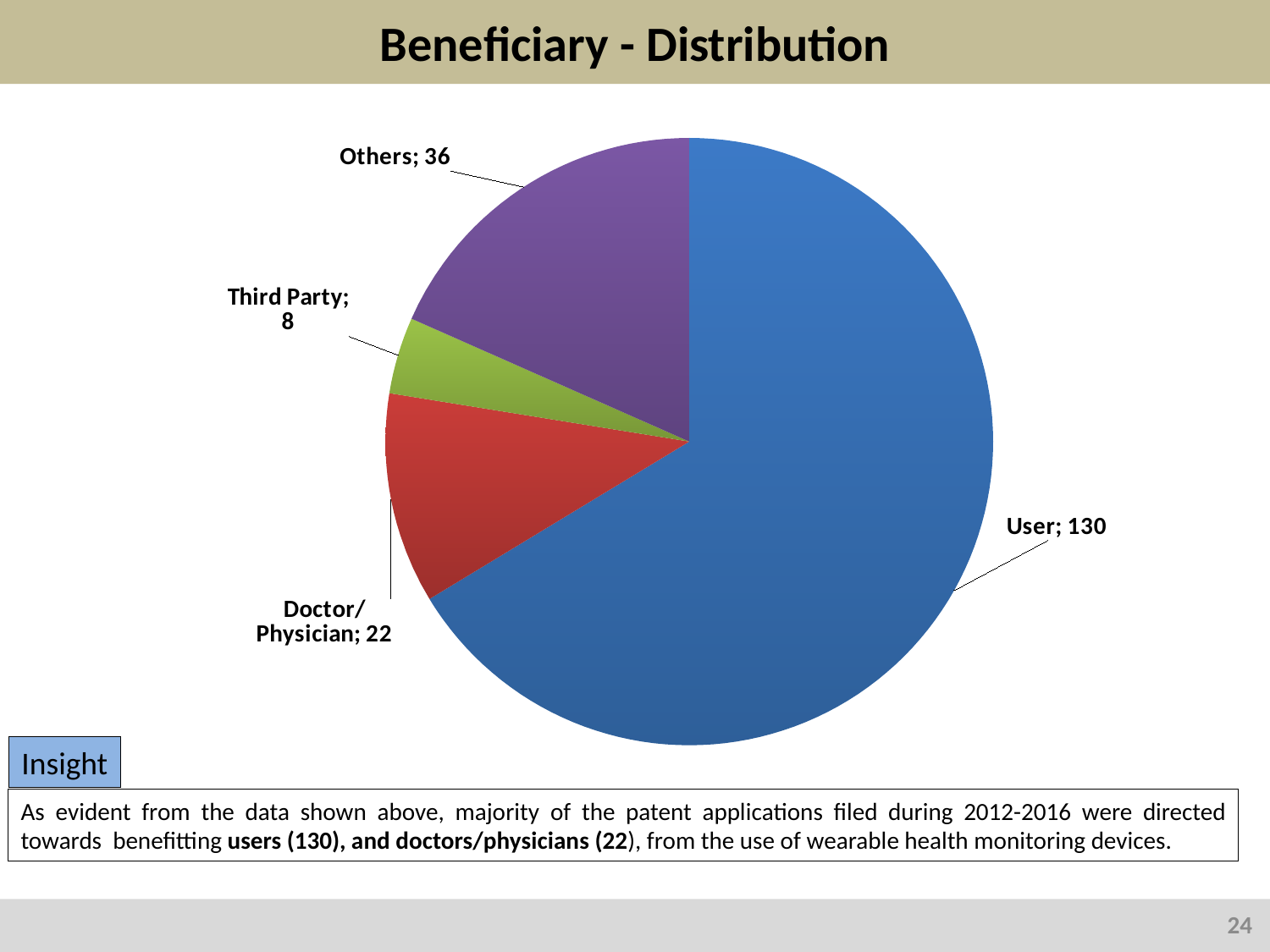
What is the difference between the values for Doctor/Physician and Third Party? 14 What is the value for Third Party in the pie chart? 8 Which category has the largest slice in the pie chart? User What is the difference between the values for User and Others? 94 What is the value for Others in the pie chart? 36 What is the total of all the values shown in the pie chart? 196 How many categories are shown in the pie chart? 4 What is the value for User in the pie chart? 130 What is the value for Doctor/Physician in the pie chart? 22 What type of chart is shown on the slide? Pie chart Which is larger, the value for Others or the value for Doctor/Physician? Others Which category has the smallest slice in the pie chart? Third Party